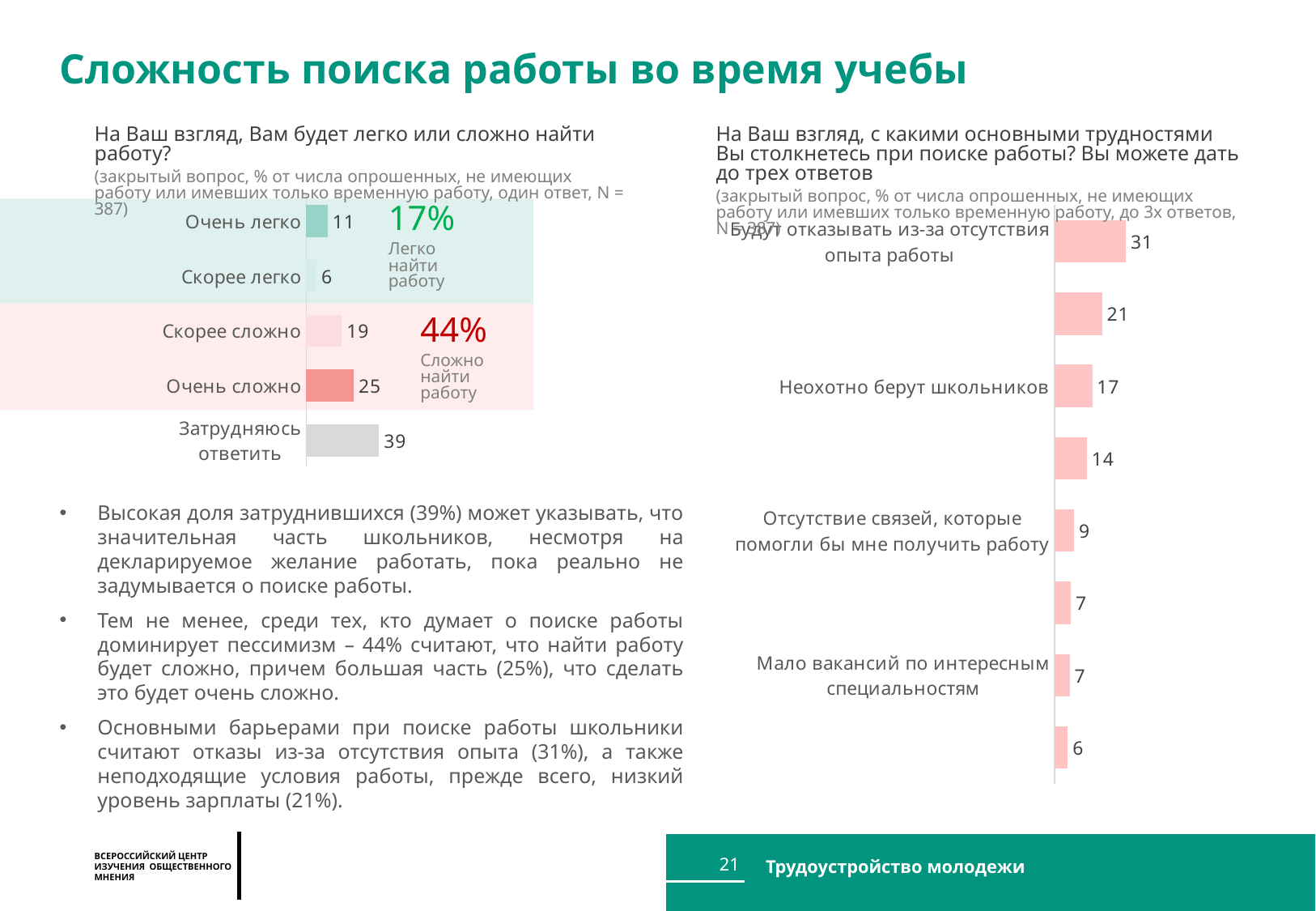
In the right chart (difficulties in finding a job), which is larger: "Неохотно берут школьников" or "Мало вакансий по интересным специальностям"? Неохотно берут школьников In the right chart (difficulties in finding a job), what is the value for "Отсутствие связей, которые помогли бы мне получить работу"? 9 In the left chart ("Вам будет легко или сложно найти работу?"), which category has the lowest value? Скорее легко In the left chart ("Вам будет легко или сложно найти работу?"), what is the value for "Очень сложно"? 25 In the right chart (difficulties in finding a job), what is the value for "Неохотно берут школьников"? 17 In the left chart ("Вам будет легко или сложно найти работу?"), what is the value for "Скорее легко"? 6 In the right chart (difficulties in finding a job), how many bars are shown? 8 In the left chart ("Вам будет легко или сложно найти работу?"), what is the difference between "Очень сложно" and "Очень легко"? 14 In the left chart ("Вам будет легко или сложно найти работу?"), how many categories are shown? 5 In the right chart (difficulties in finding a job), what is the value for "Будут отказывать из-за отсутствия опыта работы"? 31 What type of chart is the right chart (difficulties in finding a job)? Bar chart In the left chart ("Вам будет легко или сложно найти работу?"), which category has the highest value? Затрудняюсь ответить